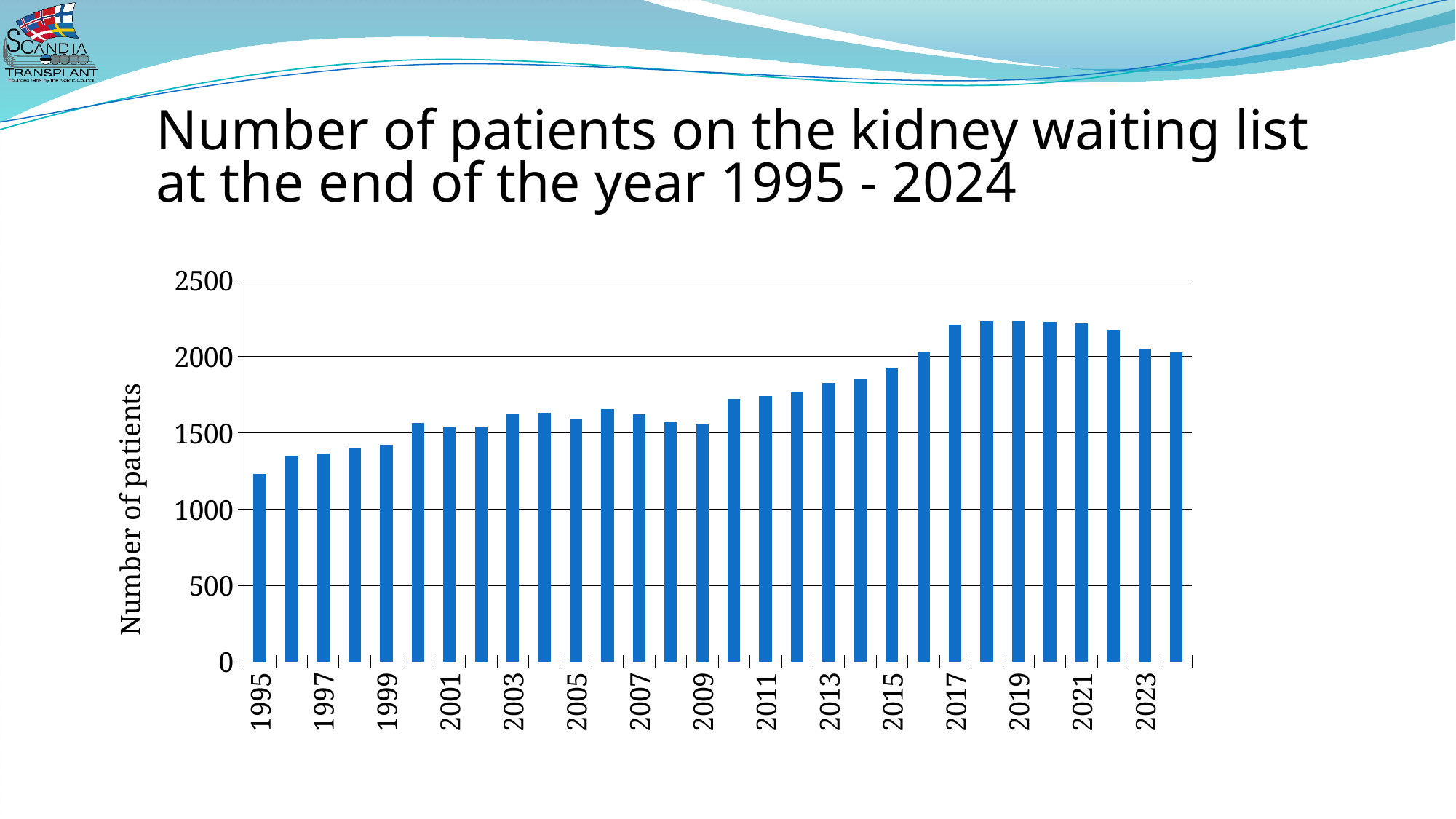
Do the values generally rise or fall from 1995 to 2018? rise Which year has the larger value, 1995 or 2017? 2017 What kind of chart is shown on the slide? bar chart How many bars (years) are plotted in the chart? 30 Is the value for 2013 greater or less than 2000? less Is the value for 2013 greater or less than 1500? greater Which year has the larger value, 2007 or 2019? 2019 Is the value for 1995 greater or less than 1500? less Which year has the lowest number of patients on the kidney waiting list? 1995 What is the label on the vertical axis of the chart? Number of patients